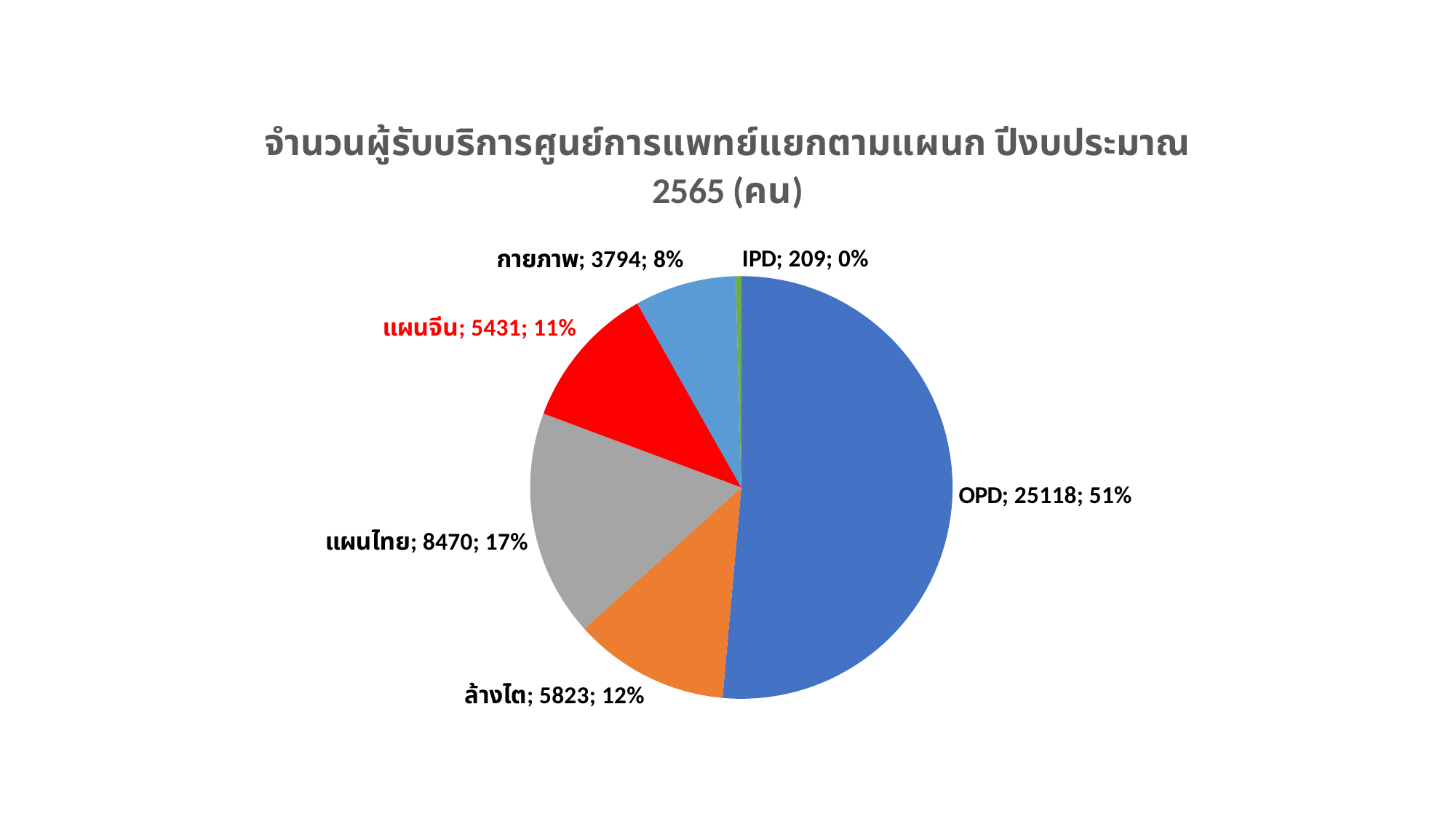
What is the value for ล้างไต? 5823 What is the value for OPD? 25118 Which is larger, the value for แผนจีน or the value for กายภาพ? แผนจีน What is the value for แผนไทย? 8470 Which department has the largest number of patients? OPD What is the value for IPD? 209 What is the difference between the values for แผนไทย and ล้างไต? 2647 How many slices does the pie chart have? 6 What share of the pie does กายภาพ represent? 8% Which department has the smallest number of patients? IPD What share of the pie does แผนจีน represent? 11% What kind of chart is shown on the slide? pie chart